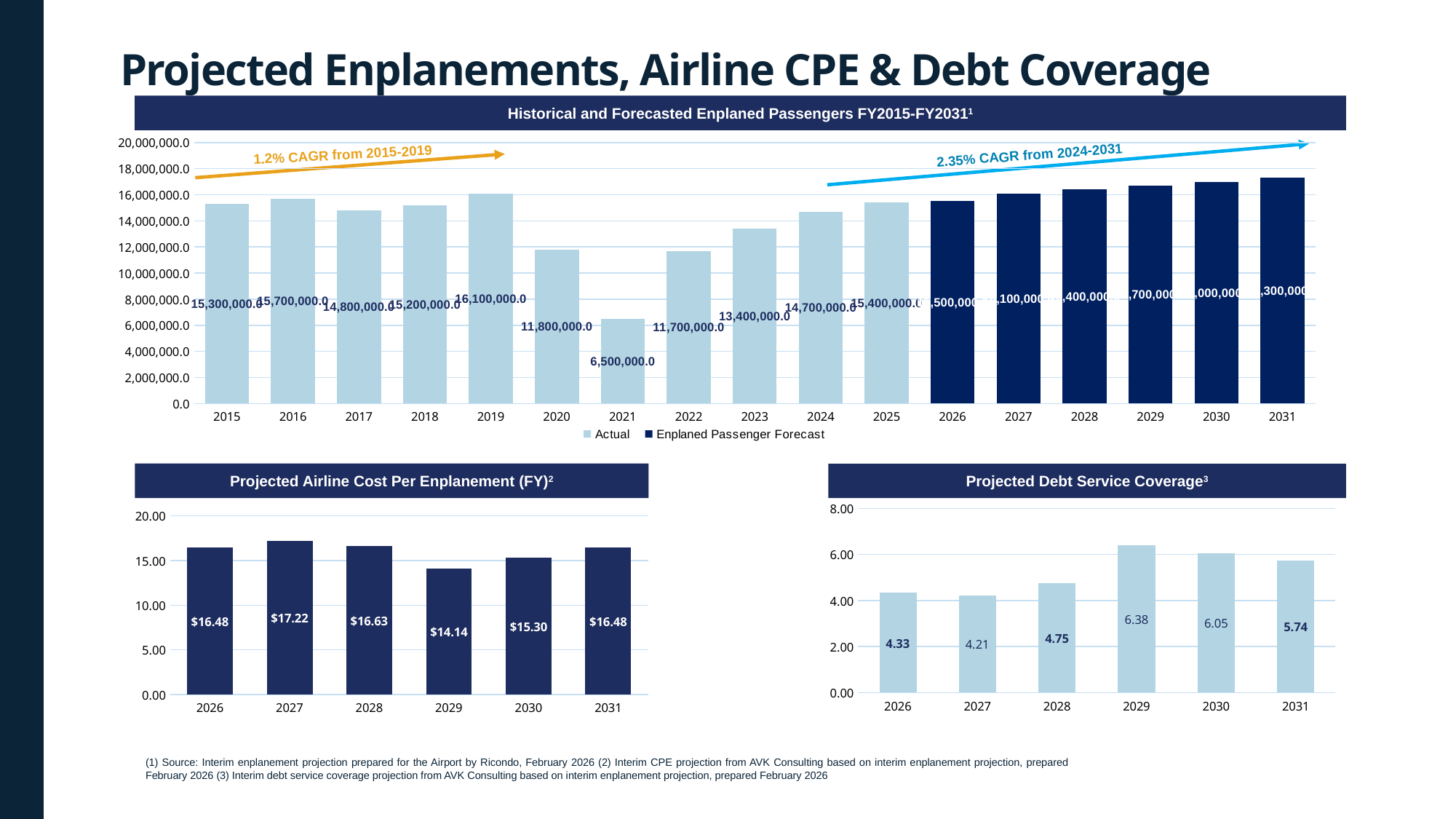
In the Projected Airline Cost Per Enplanement chart, what is the value for 2029? $14.14 In the Historical and Forecasted Enplaned Passengers chart, is the value for 2031 greater or less than 16,000,000.0? greater What kind of chart is the Projected Debt Service Coverage chart? bar chart In the Historical and Forecasted Enplaned Passengers chart, what is the value for 2021? 6,500,000.0 In the Historical and Forecasted Enplaned Passengers chart, how many years are plotted? 17 In the Projected Airline Cost Per Enplanement chart, what is the difference between the 2027 and 2029 values? $3.08 In the Historical and Forecasted Enplaned Passengers chart, what is the difference between the 2019 and 2020 values? 4,300,000.0 In the Historical and Forecasted Enplaned Passengers chart, how many series does the legend list? 2 In the Historical and Forecasted Enplaned Passengers chart, which year has the lowest value? 2021 In the Projected Debt Service Coverage chart, which is larger, the value for 2030 or 2031? 2030 In the Projected Airline Cost Per Enplanement chart, which year has the highest value? 2027 In the Projected Debt Service Coverage chart, which year has the highest value? 2029